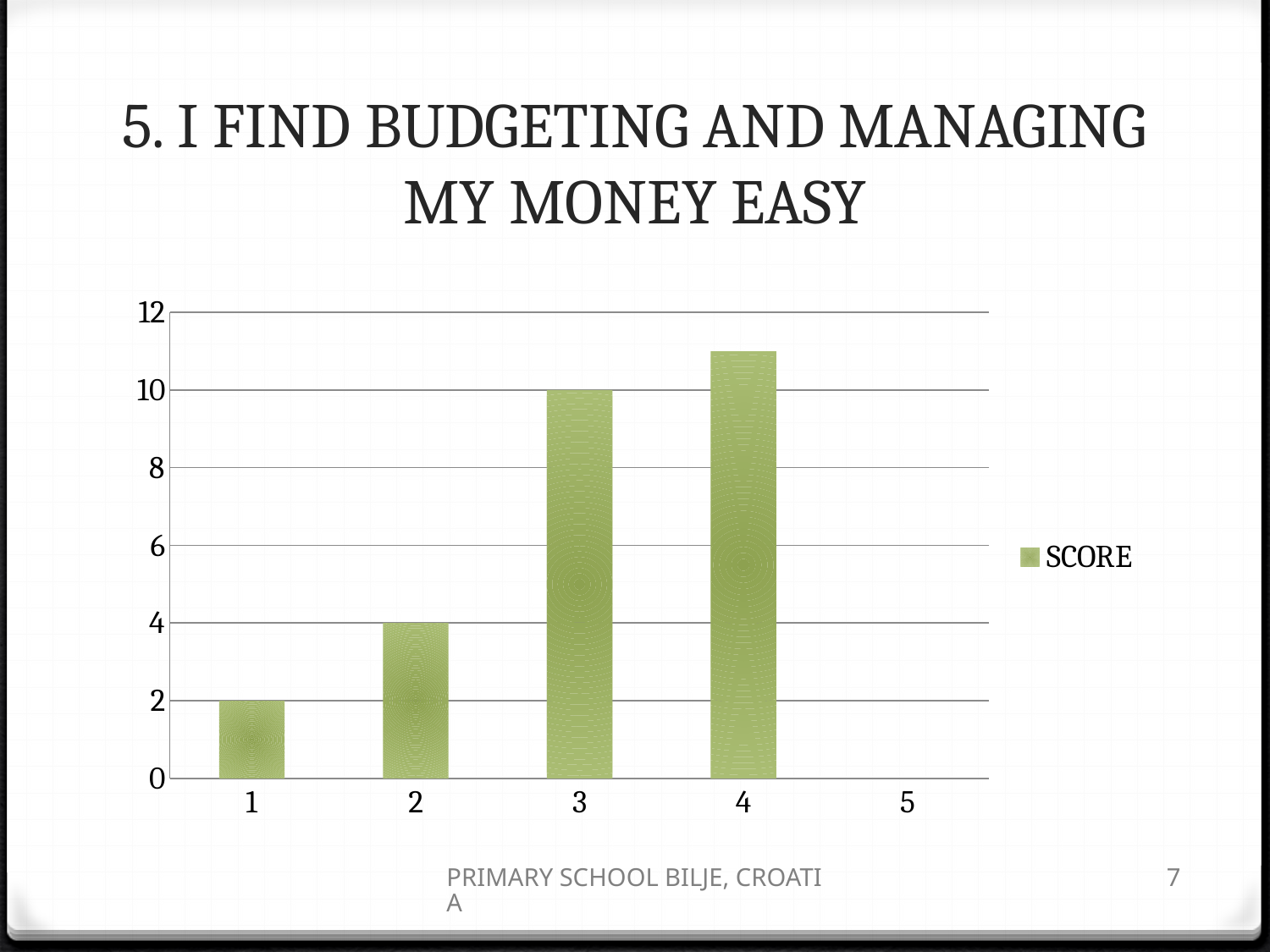
What is the difference between the values for category 3 and category 1? 8 What is the value for category 2? 4 How many categories are shown on the x axis? 5 Which category has the lowest value? 5 What is the value for category 5? 0 Which has the larger value, category 2 or category 3? 3 How many series does the legend list? 1 What is the value for category 3? 10 Which category has the highest value? 4 Is the value for category 4 greater or less than 10? greater What kind of chart is shown on the slide? bar chart What is the value for category 1? 2